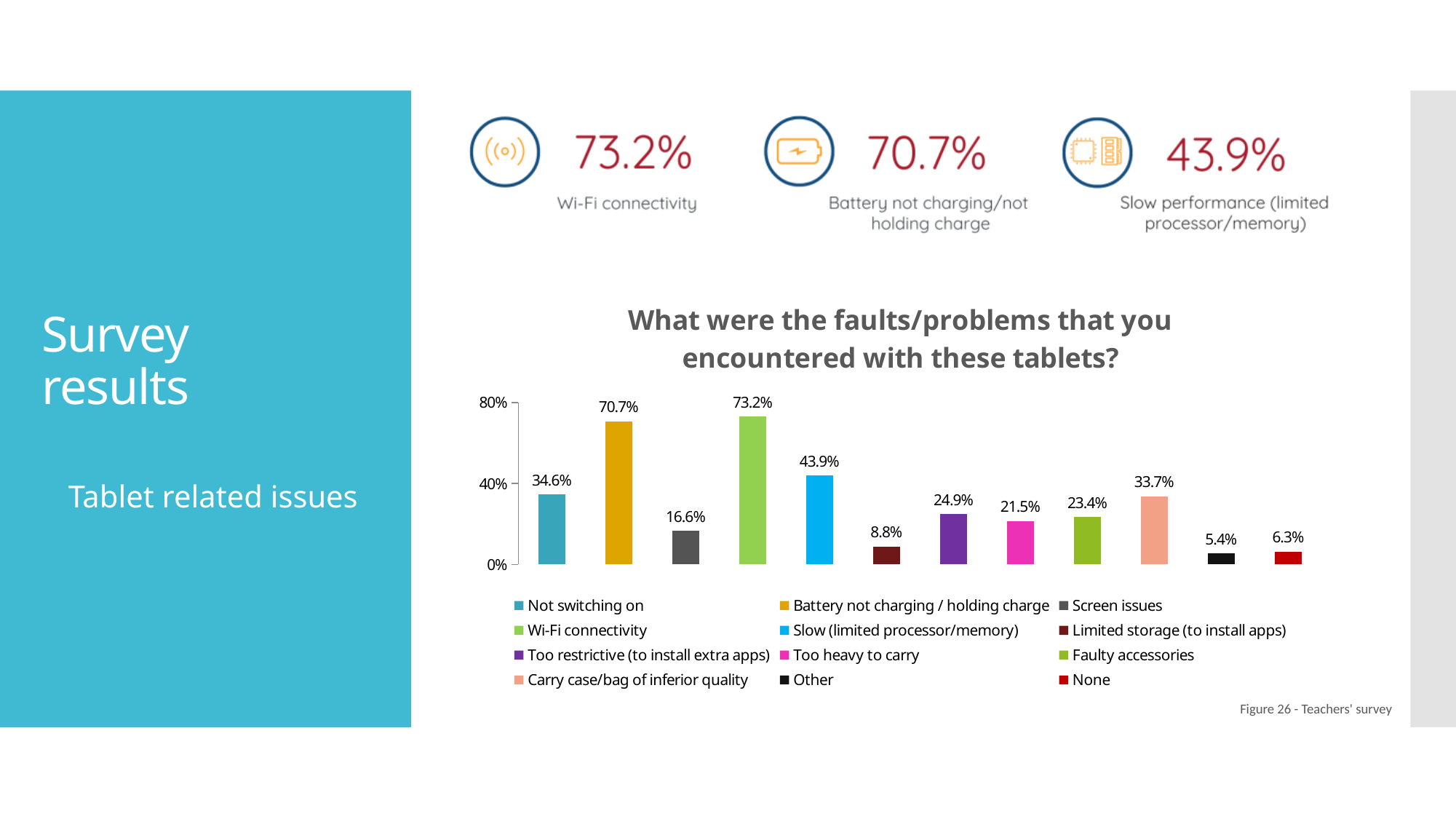
How many entries does the chart legend list? 12 How many bars are plotted in the chart? 12 What is the title of the chart? What were the faults/problems that you encountered with these tablets? Which fault/problem has the highest value in the chart? Wi-Fi connectivity Is the value for Slow (limited processor/memory) greater or less than 40%? greater What is the value for Carry case/bag of inferior quality? 33.7% Which is larger: the value for Too restrictive (to install extra apps) or the value for Too heavy to carry? Too restrictive (to install extra apps) What is the value for Wi-Fi connectivity in the chart? 73.2% What percentage of respondents reported Screen issues? 16.6% Which category has the lowest value in the chart? Other What is the difference between the values for Wi-Fi connectivity and Battery not charging / holding charge? 2.5 percentage points What type of chart is shown on the slide? Bar chart